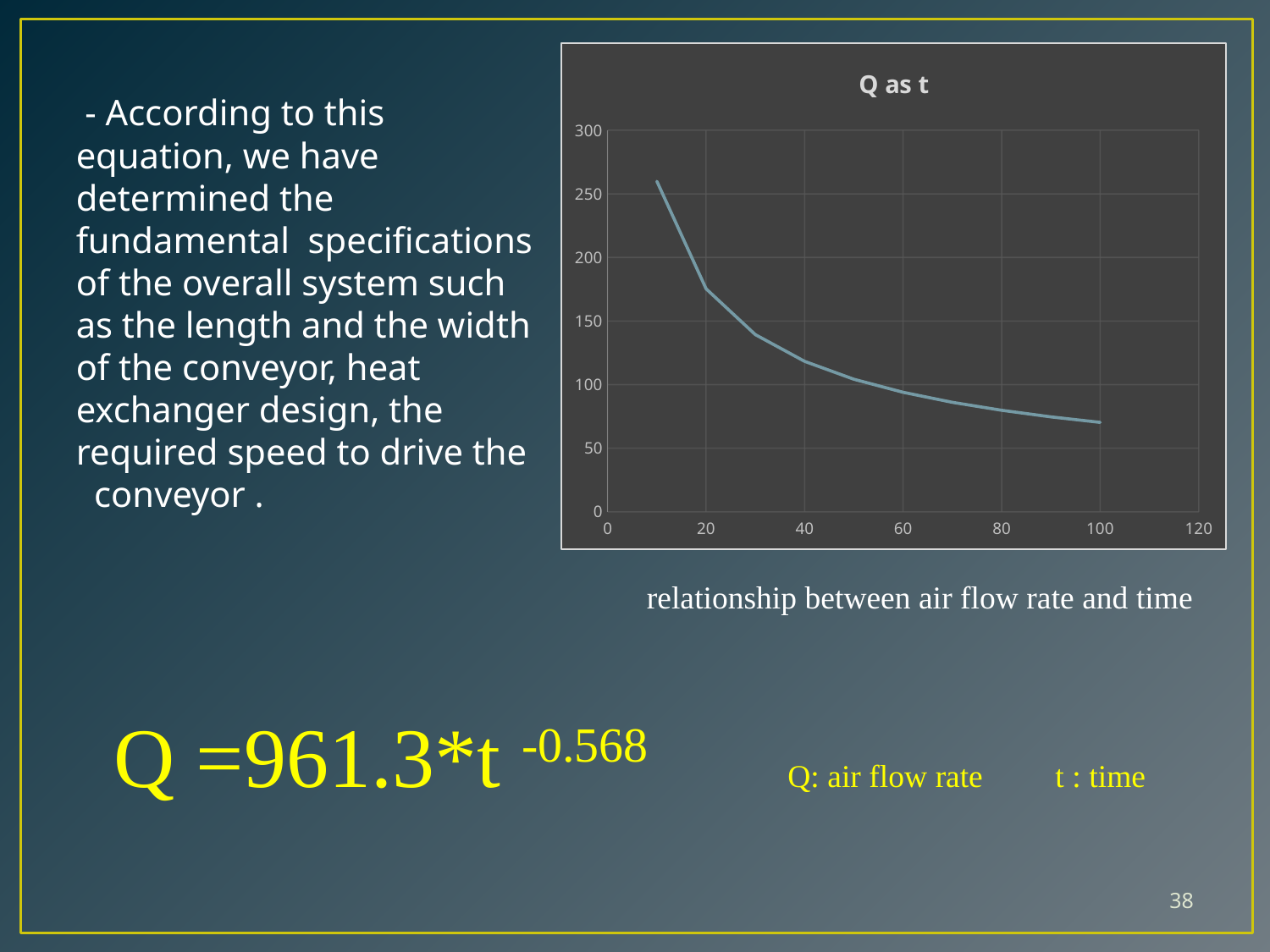
Is the value of Q at t = 40 greater or less than 100? greater Do the values on the chart rise or fall as t increases along the x axis? fall What kind of chart is shown on the slide? line chart Is the value of Q at t = 100 greater or less than 100? less Is the value of Q at t = 80 greater or less than 100? less What is the highest tick value shown on the y axis of the chart? 300 What is the title of the chart? Q as t Which has the larger Q value on the chart, t = 20 or t = 80? t = 20